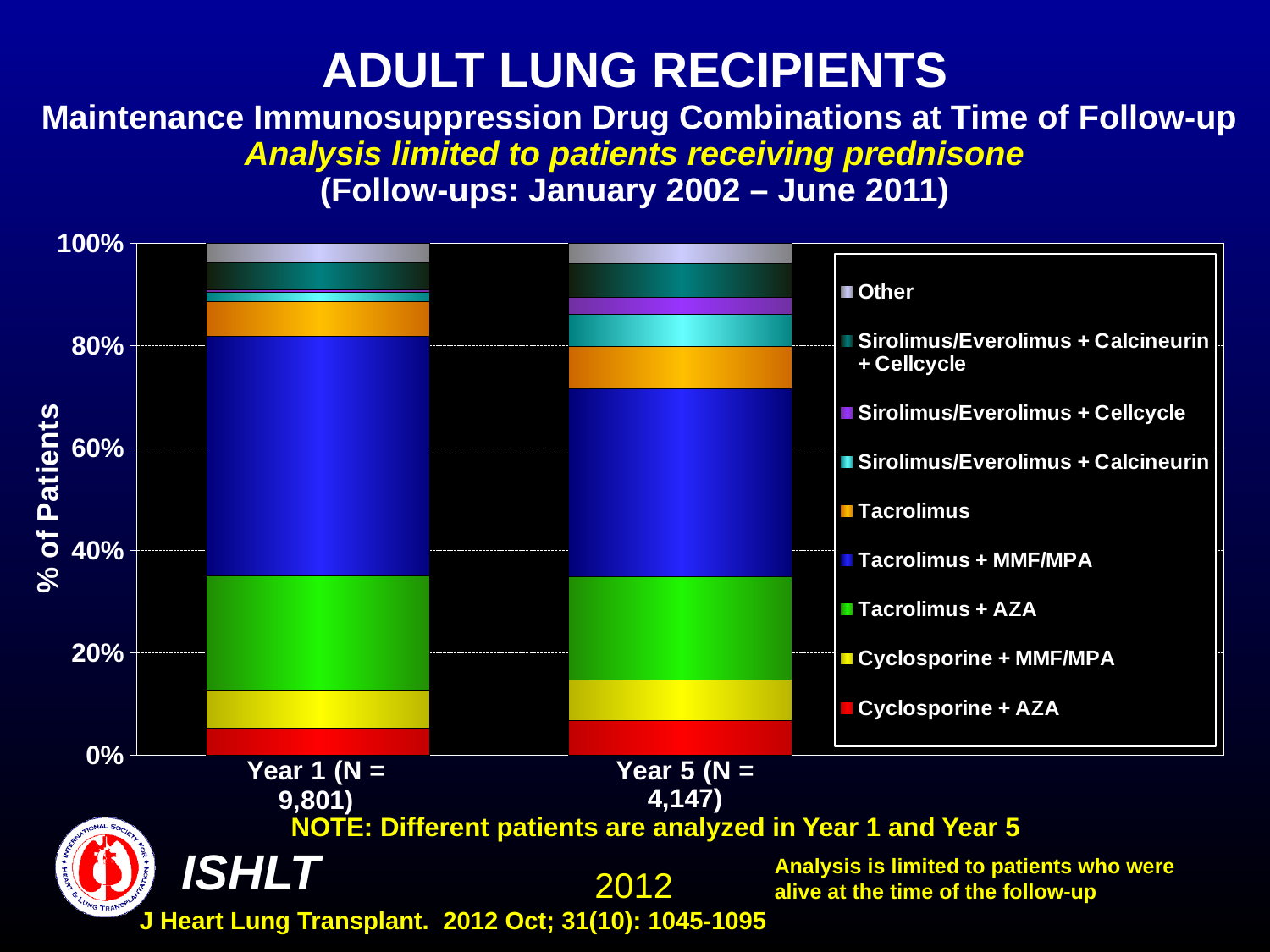
Does the share of Tacrolimus + MMF/MPA rise or fall from Year 1 to Year 5? fall Is the share of Tacrolimus (alone) larger in Year 1 or in Year 5? Year 5 What kind of chart is shown on the slide? Stacked bar chart Which drug combination makes up the largest share of the Year 1 bar? Tacrolimus + MMF/MPA Is the share of Sirolimus/Everolimus + Cellcycle larger in Year 1 or in Year 5? Year 5 Is the share of Cyclosporine + AZA in the Year 1 bar greater or less than 20%? less How many drug combination series does the legend list? 9 Which drug combination makes up the largest share of the Year 5 bar? Tacrolimus + MMF/MPA How many bars (follow-up time points) are plotted in the chart? 2 Is the share of Tacrolimus + MMF/MPA in the Year 1 bar greater or less than 40%? greater What is the label of the y axis? % of Patients What is the N shown for the Year 1 bar? 9,801